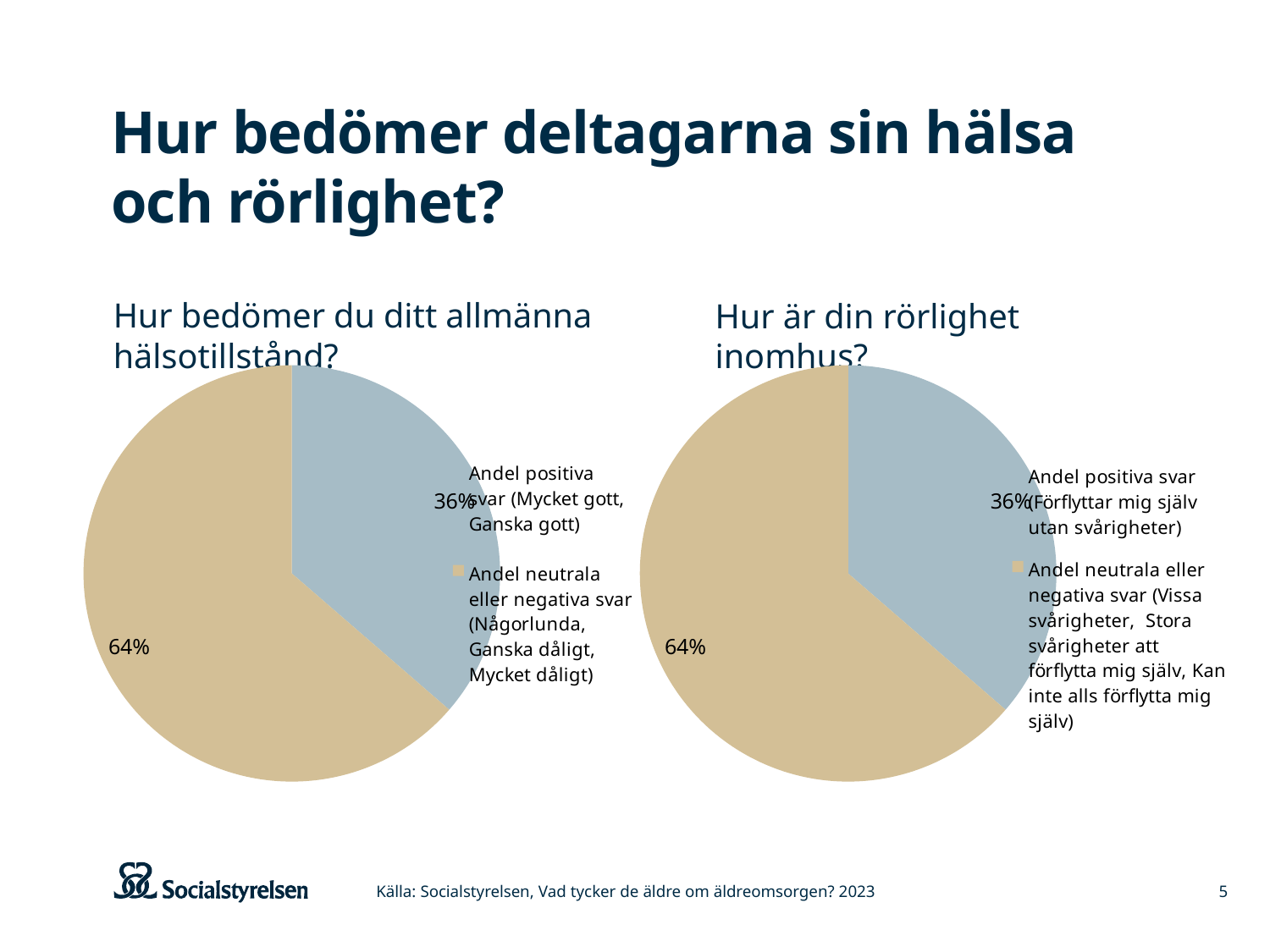
In the right chart (Hur är din rörlighet inomhus?), is the positive share larger or smaller than the neutral/negative share? smaller In the left chart (Hur bedömer du ditt allmänna hälsotillstånd?), what is the difference in percentage points between the neutral/negative share and the positive share? 28 percentage points In the left chart (Hur bedömer du ditt allmänna hälsotillstånd?), which category has the largest slice? Andel neutrala eller negativa svar In the right chart (Hur är din rörlighet inomhus?), what share of responses are positive (Andel positiva svar)? 36% How many legend entries does the left chart (Hur bedömer du ditt allmänna hälsotillstånd?) list? 2 In the left chart (Hur bedömer du ditt allmänna hälsotillstånd?), what share of responses are positive (Andel positiva svar)? 36% In the right chart (Hur är din rörlighet inomhus?), what share of responses are neutral or negative (Andel neutrala eller negativa svar)? 64% What type of chart is used on the left (Hur bedömer du ditt allmänna hälsotillstånd?)? pie chart What is the title of the right chart? Hur är din rörlighet inomhus? In the left chart (Hur bedömer du ditt allmänna hälsotillstånd?), what share of responses are neutral or negative (Andel neutrala eller negativa svar)? 64% How many slices does the right chart (Hur är din rörlighet inomhus?) have? 2 In the right chart (Hur är din rörlighet inomhus?), which category has the smallest slice? Andel positiva svar